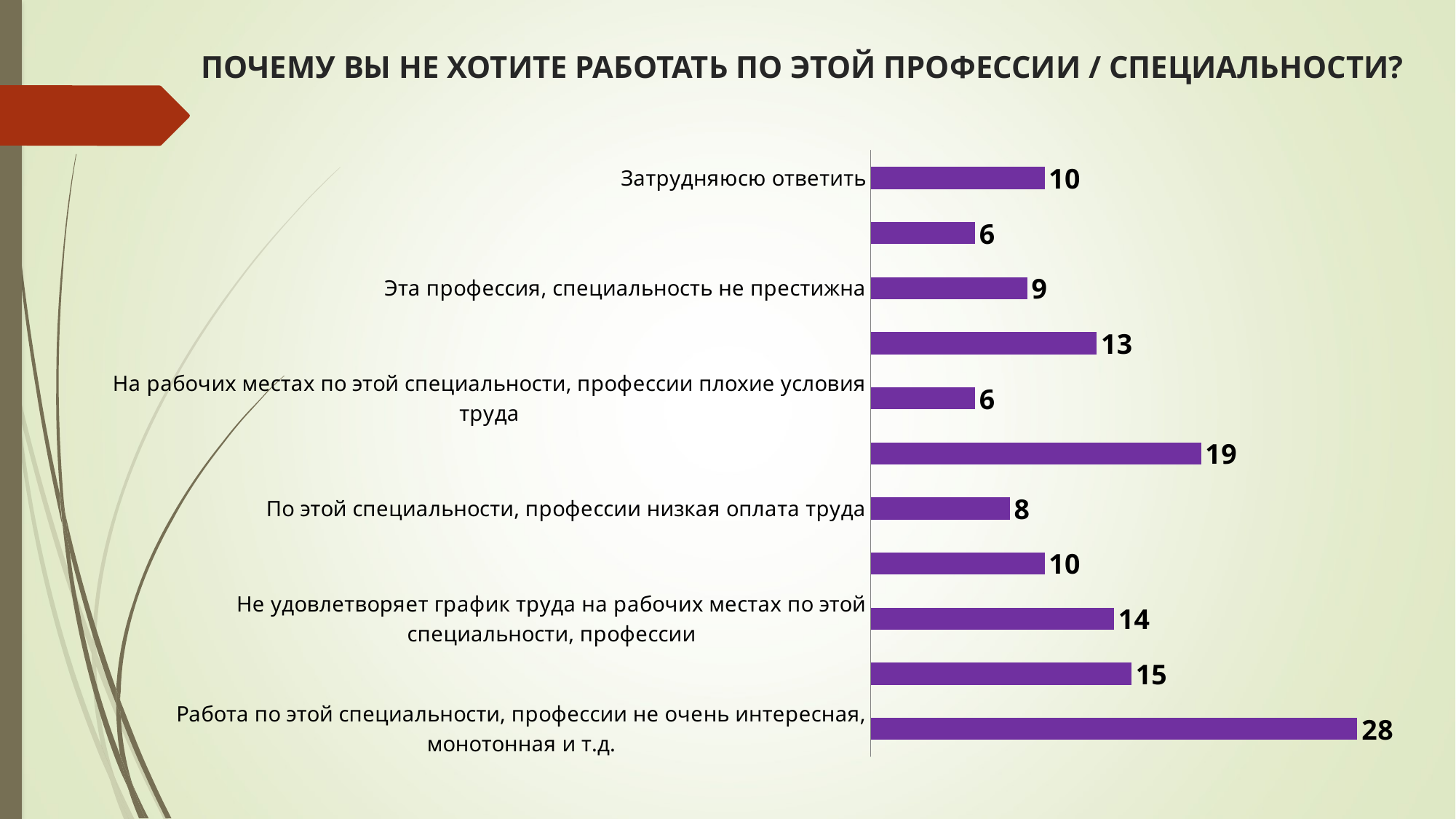
What is the value for "По этой специальности, профессии низкая оплата труда"? 8 Which is larger: the value for "Затрудняюсь ответить" or the value for "Эта профессия, специальность не престижна"? Затрудняюсь ответить Which category has the highest value? Работа по этой специальности, профессии не очень интересная, монотонная и т.д. What is the value for "Затрудняюсь ответить"? 10 What is the title of the slide? ПОЧЕМУ ВЫ НЕ ХОТИТЕ РАБОТАТЬ ПО ЭТОЙ ПРОФЕССИИ / СПЕЦИАЛЬНОСТИ? What is the difference between the values for "Работа по этой специальности, профессии не очень интересная, монотонная и т.д." and "Не удовлетворяет график труда на рабочих местах по этой специальности, профессии"? 14 What is the value for "На рабочих местах по этой специальности, профессии плохие условия труда"? 6 What is the value for "Работа по этой специальности, профессии не очень интересная, монотонная и т.д."? 28 What is the value for "Не удовлетворяет график труда на рабочих местах по этой специальности, профессии"? 14 How many bars are plotted in the chart? 11 What type of chart is shown on the slide? bar chart What is the value for "Эта профессия, специальность не престижна"? 9